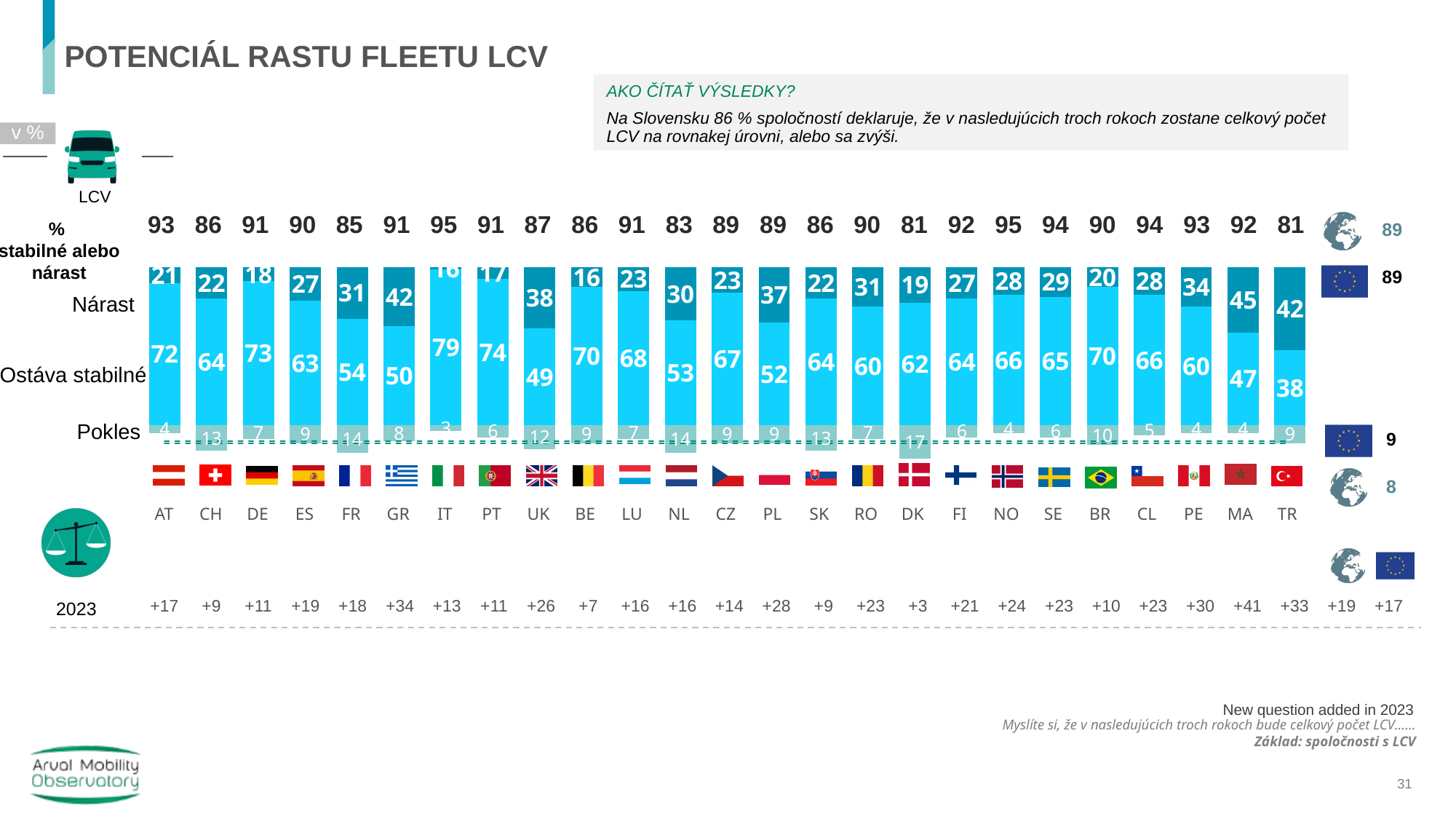
Which country has the lowest Ostáva stabilné value? TR What is the total of the Nárast and Ostáva stabilné segments for UK? 87 Which country has the highest Nárast value? MA What is the Ostáva stabilné value for IT? 79 What kind of chart is shown on the slide? stacked bar chart How many countries are shown along the x axis of the chart? 25 What is the '% stabilné alebo nárast' value shown above the bar for SK? 86 What is the Pokles value for DK? 17 What is the Nárast value for GR? 42 What is the difference between the Nárast value for MA and the Nárast value for AT? 24 Which country has the highest Pokles value? DK Which has the larger Ostáva stabilné value, DE or FR? DE